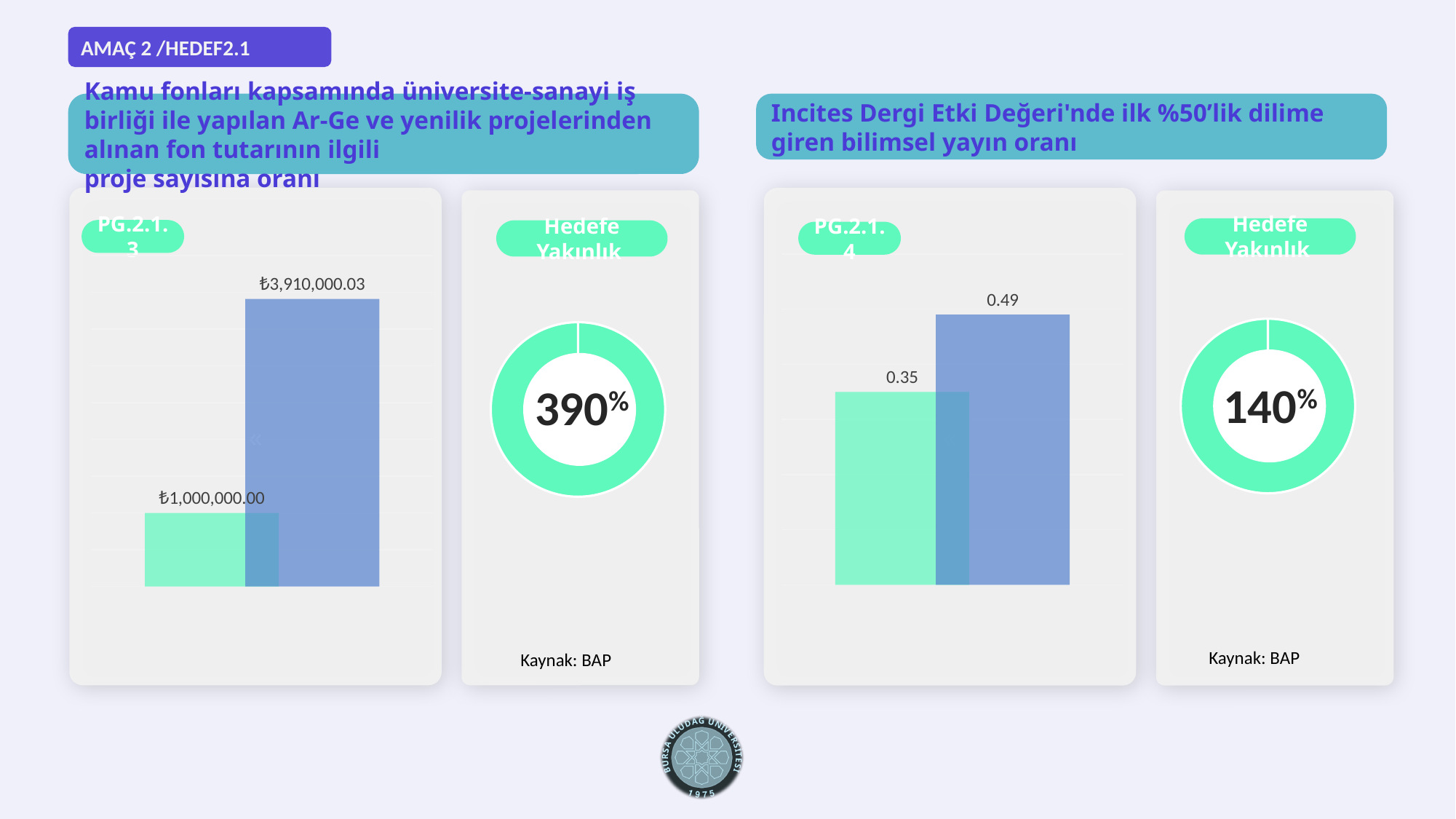
On the PG.2.1.4 chart, what value is printed on the blue bar? 0.49 On the PG.2.1.3 chart, what value is printed on the taller blue bar? ₺3,910,000.03 How many bars are plotted on the PG.2.1.3 chart? 2 On the PG.2.1.4 chart, which bar has the lowest value? the green bar (0.35) On the PG.2.1.3 chart, which bar is higher, the green bar or the blue bar? the blue bar On the PG.2.1.3 chart, what is the difference between the two printed values? ₺2,910,000.03 What percentage is shown in the centre of the Hedefe Yakınlık donut chart next to PG.2.1.4? 140% On the PG.2.1.3 chart, what value is printed on the green bar? ₺1,000,000.00 On the PG.2.1.4 chart, what value is printed on the green bar? 0.35 On the PG.2.1.4 chart, what is the difference between the blue bar value and the green bar value? 0.14 What kind of chart is the PG.2.1.3 chart? bar chart What percentage is shown in the centre of the Hedefe Yakınlık donut chart next to PG.2.1.3? 390%